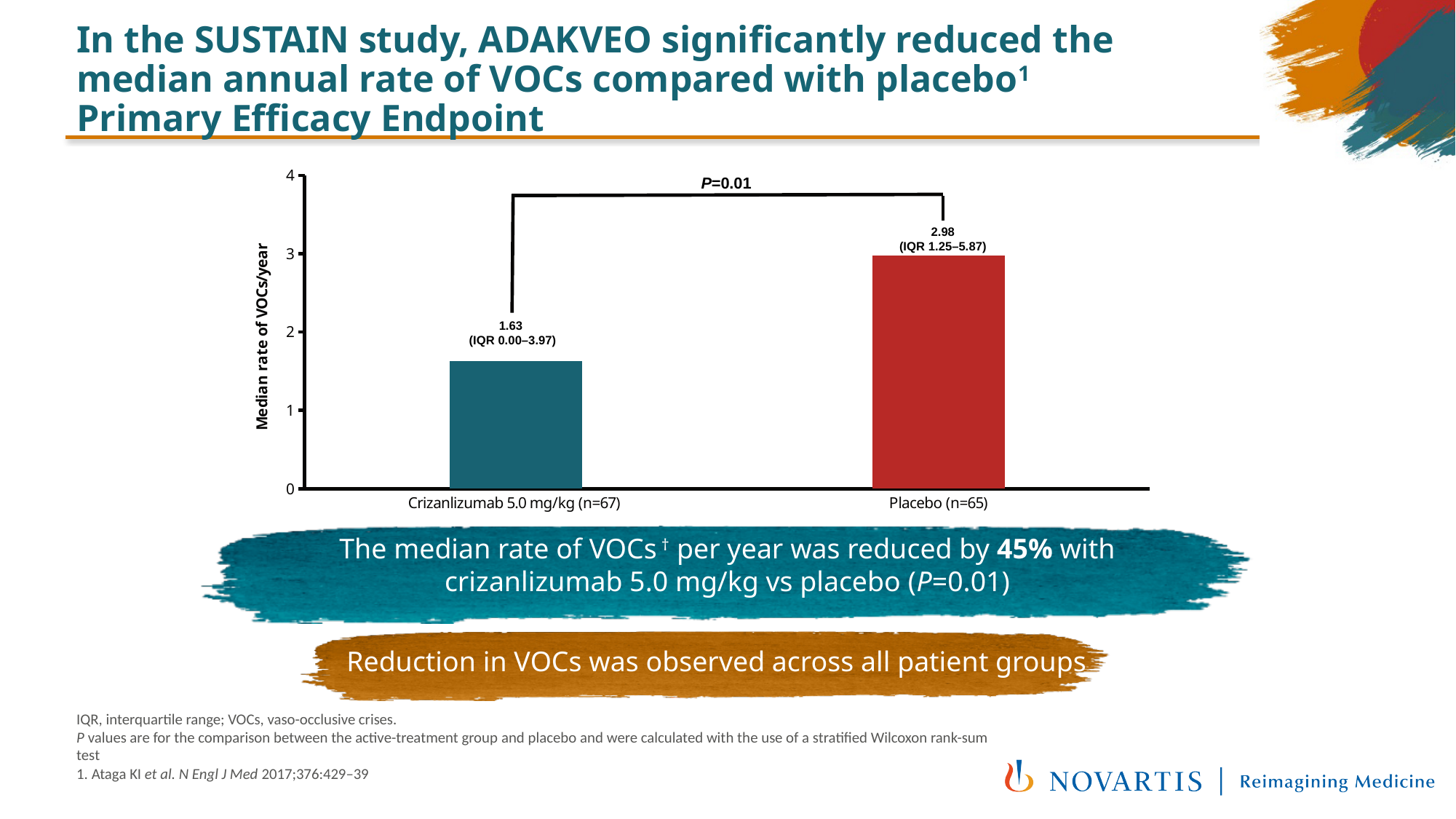
Which group has the lower median rate of VOCs/year? Crizanlizumab 5.0 mg/kg (n=67) What is the label of the y axis of the chart? Median rate of VOCs/year Is the median rate of VOCs/year for Placebo greater or less than 2? greater Which group has the higher median rate of VOCs/year? Placebo (n=65) What P value is shown above the bars in the chart? P=0.01 What kind of chart is shown on the slide? Bar chart What is the median rate of VOCs/year for Crizanlizumab 5.0 mg/kg (n=67)? 1.63 What is the difference in median rate of VOCs/year between Placebo and Crizanlizumab 5.0 mg/kg? 1.35 How many groups are plotted in the chart? 2 Is the median rate of VOCs/year for Crizanlizumab 5.0 mg/kg greater or less than 2? less What is the IQR shown for the Placebo group? 1.25–5.87 What is the median rate of VOCs/year for Placebo (n=65)? 2.98